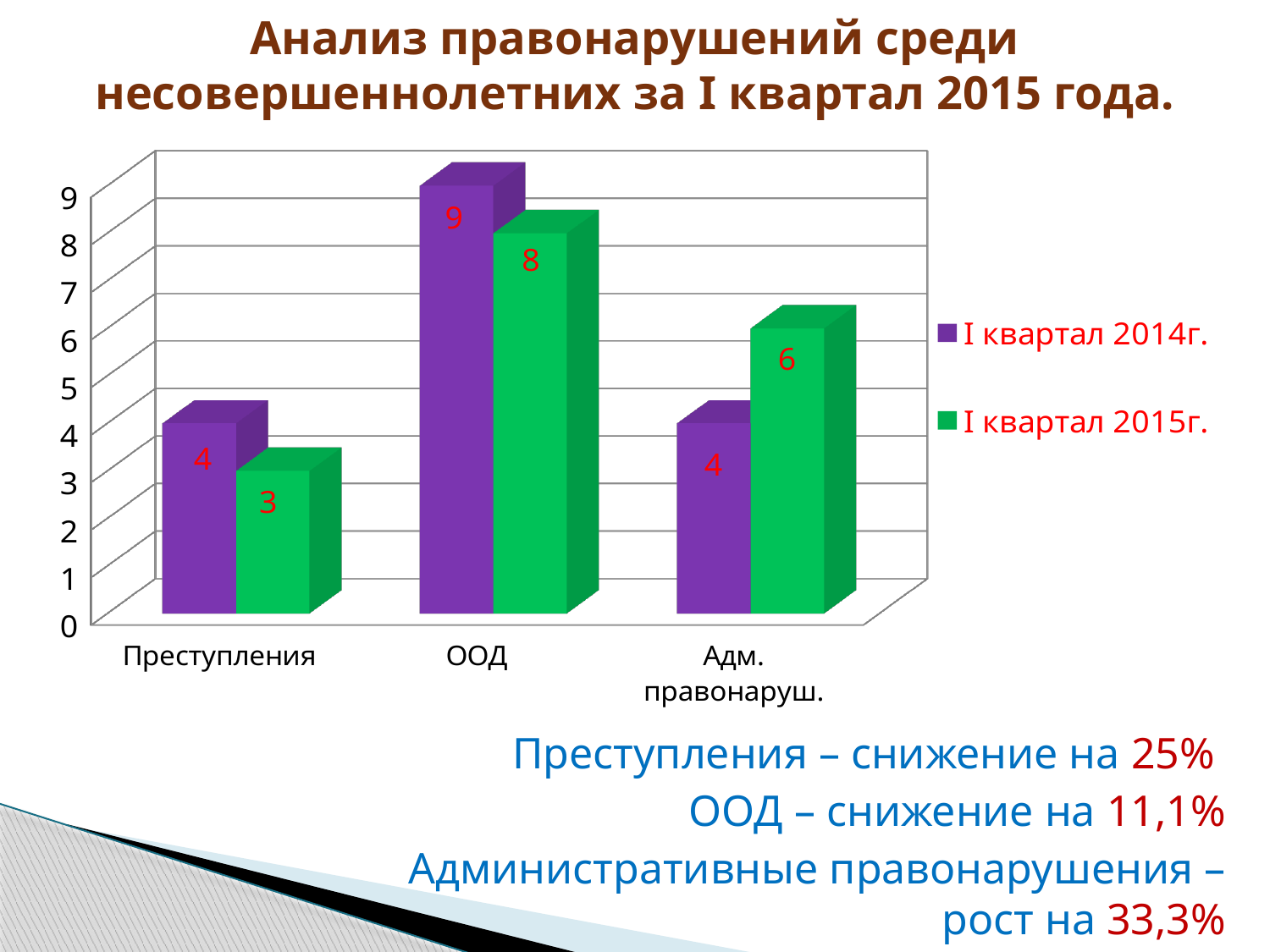
What is the difference between the I квартал 2014г. and I квартал 2015г. values for Адм. правонаруш.? 2 What kind of chart is shown on the slide? bar chart Which category has the lowest value in I квартал 2015г.? Преступления What is the value for ООД in I квартал 2015г.? 8 Which category has the highest value in I квартал 2014г.? ООД How many series does the legend list? 2 What is the value for Адм. правонаруш. in I квартал 2015г.? 6 What is the difference between the I квартал 2014г. and I квартал 2015г. values for Преступления? 1 What colour are the bars for I квартал 2015г.? green What is the value for Преступления in I квартал 2014г.? 4 Which is larger for ООД: the I квартал 2014г. value or the I квартал 2015г. value? I квартал 2014г. How many categories are shown on the x axis? 3